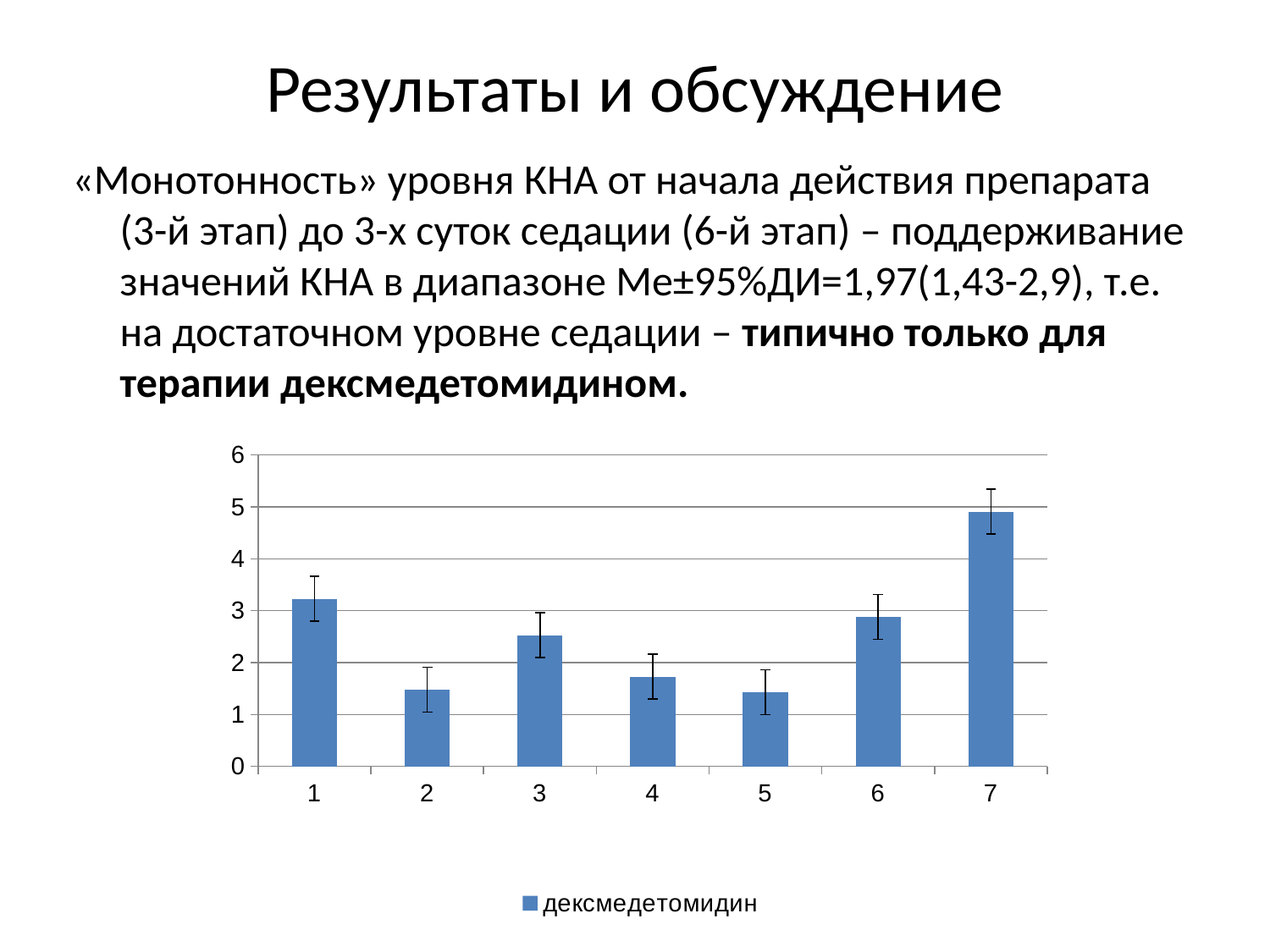
Is the value for category 3 greater or less than 2? greater What kind of chart is shown on the slide? bar chart How many categories are shown on the x axis of the chart? 7 Is the value for category 4 greater or less than 2? less Which is larger, the value for category 6 or the value for category 4? category 6 How many series does the chart legend list? 1 What is the name of the series shown in the chart legend? дексмедетомидин Is the value for category 7 greater or less than 4? greater Which is larger, the value for category 1 or the value for category 3? category 1 What is the highest value shown on the y axis of the chart? 6 Which category has the highest bar in the chart? 7